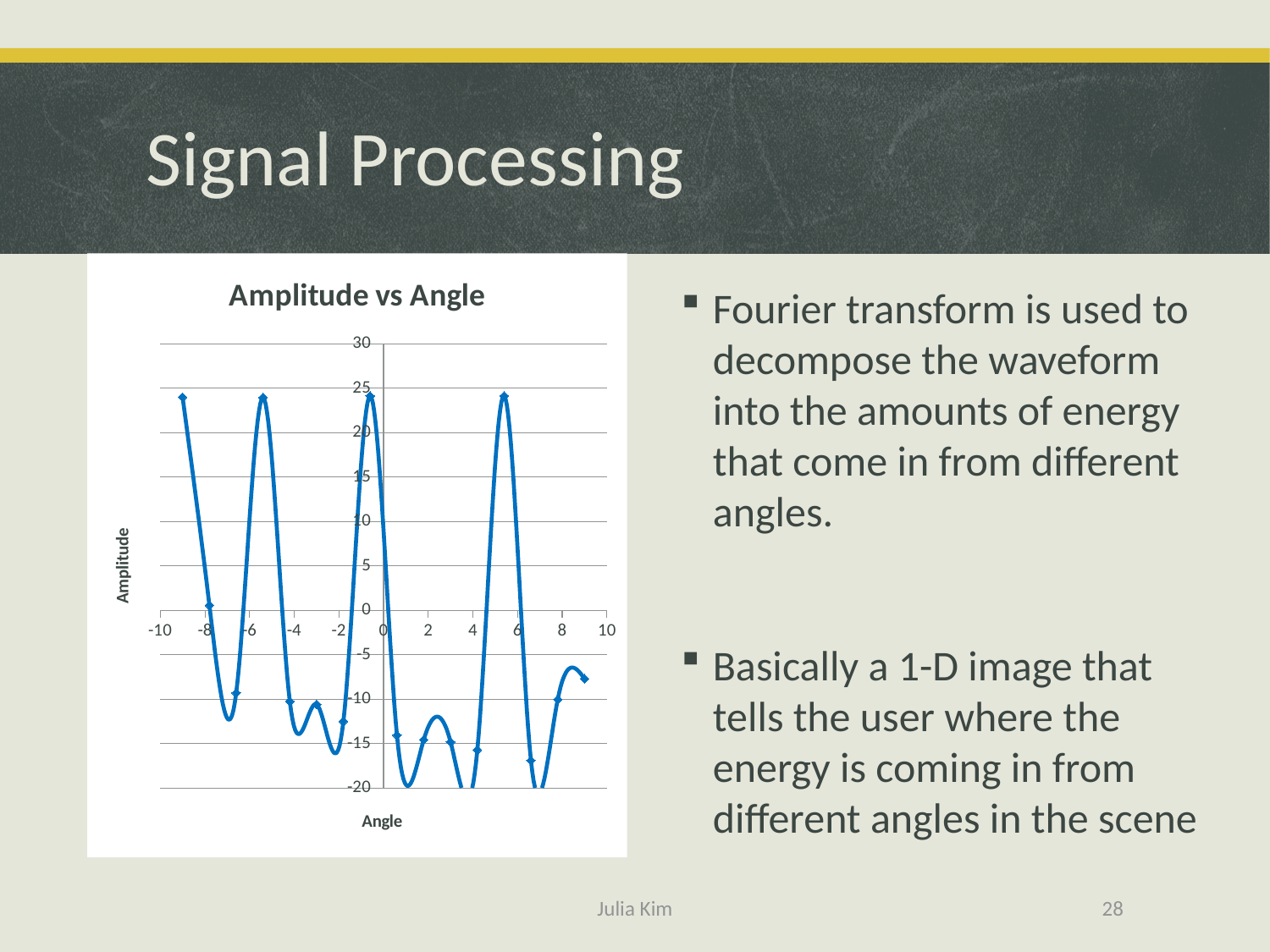
What is the title of the chart? Amplitude vs Angle What kind of chart is shown on the slide? line chart Does the amplitude rise or fall as the angle goes from 0 to 2? fall Is the amplitude at angle -2 greater or less than -10? less Which is larger, the amplitude at angle 0 or the amplitude at angle 2? angle 0 Which is larger, the amplitude at angle -9 or the amplitude at angle -6? angle -9 What is the label on the vertical axis of the chart? Amplitude Is the amplitude at angle 2 greater or less than -10? less Is the amplitude at angle 7 greater or less than -10? less